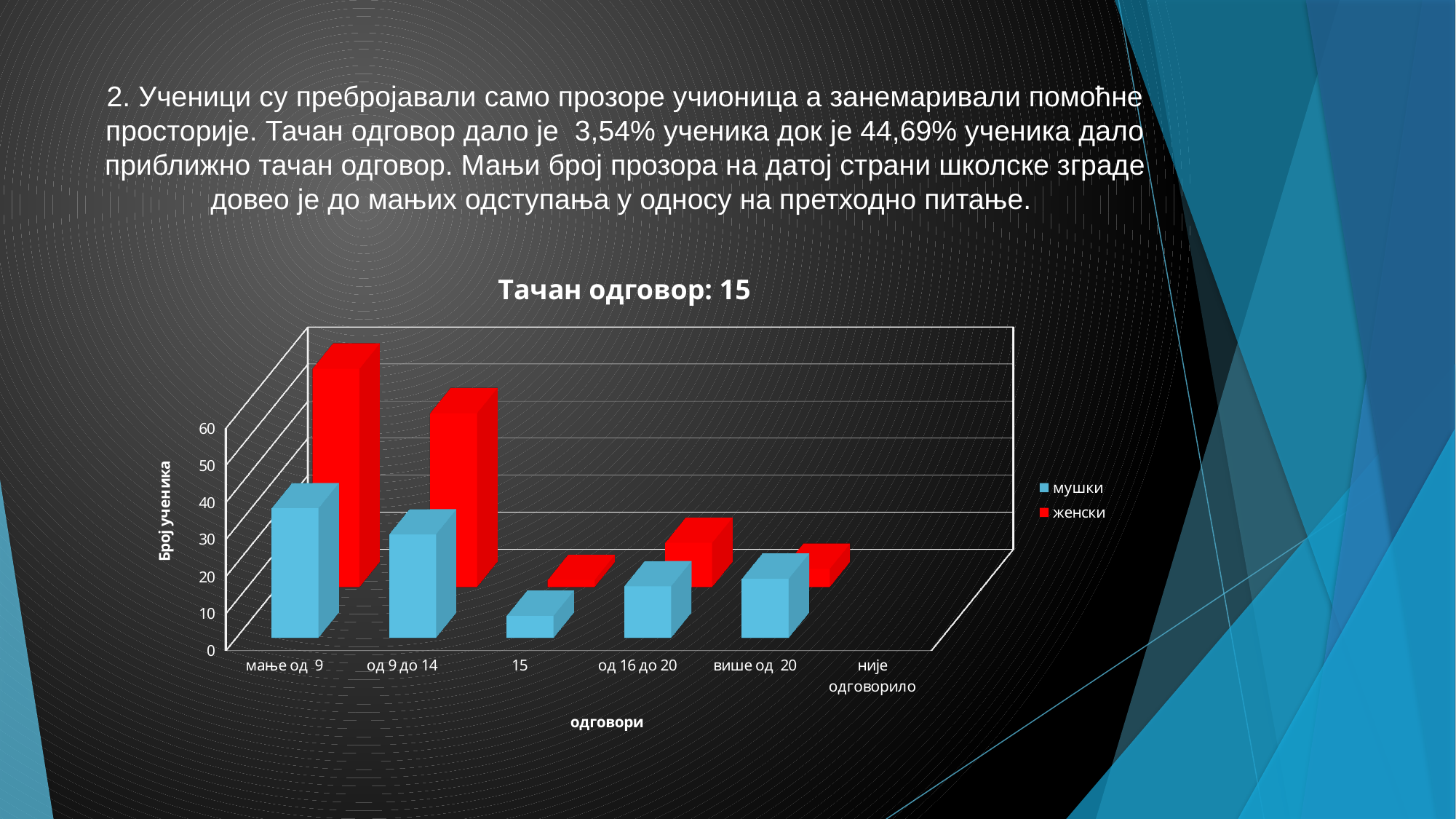
For the category мање од 9, which series has the larger value, мушки or женски? женски Which category has the highest value for the series мушки? мање од 9 For the series мушки, which category has the larger value, од 9 до 14 or од 16 до 20? од 9 до 14 How many series does the legend list? 2 What is the label of the vertical axis? Број ученика Is the value for женски in the category 15 greater or less than 10? less How many categories are shown on the x axis? 6 What kind of chart is shown on the slide? bar chart Is the value for мушки in the category мање од 9 greater or less than 30? greater Which category has the highest value for the series женски? мање од 9 Do the values for the series мушки rise or fall from мање од 9 to 15? fall What is the title of the chart? Тачан одговор: 15